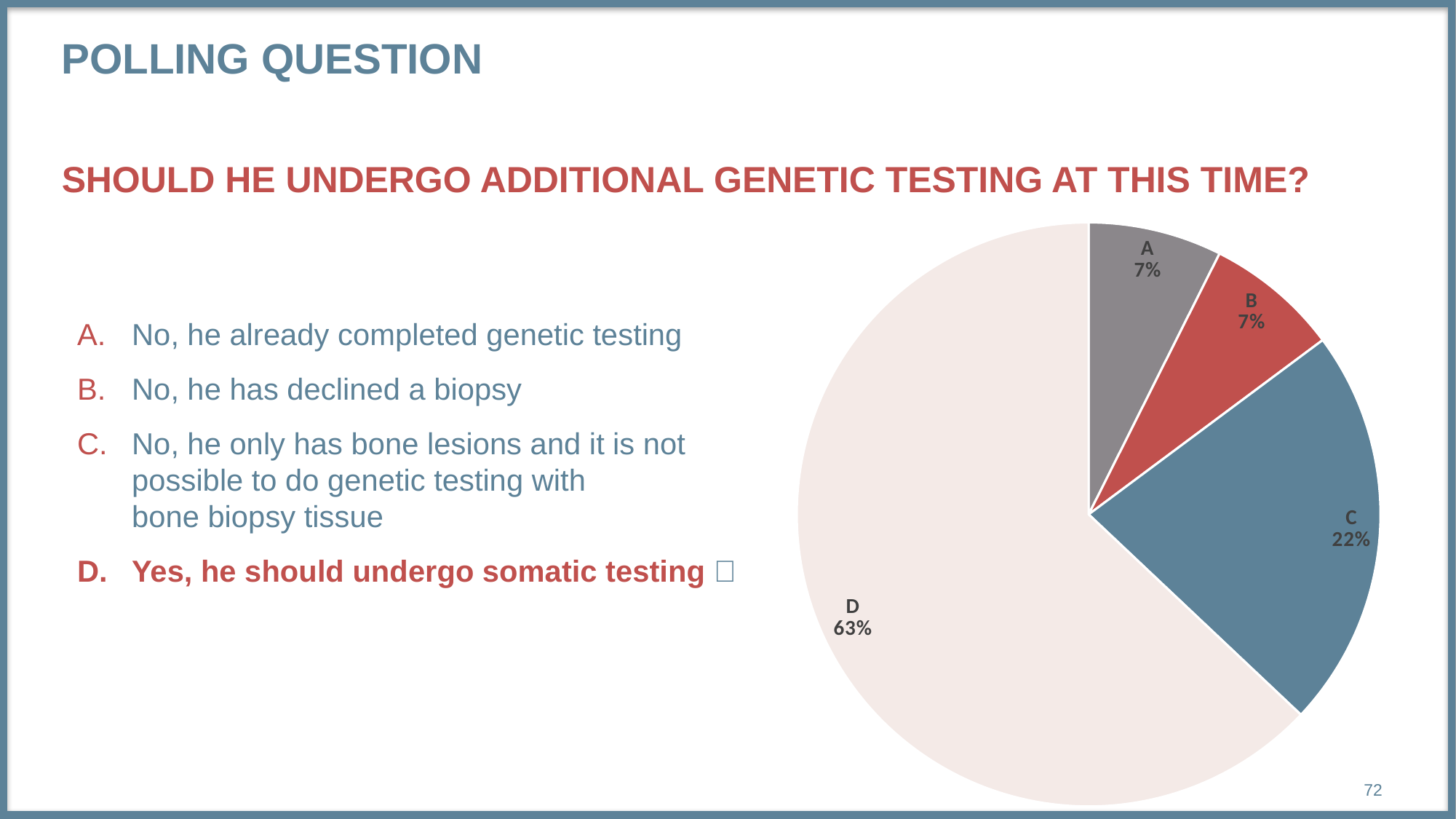
What colour is the slice for option C? Blue What percentage of responses does slice D represent? 63% What percentage of responses does slice C represent? 22% How many slices does the pie chart have? 4 Which is larger, the share for C or the share for B? C What is the combined share of slices A and B? 14% What percentage of responses does slice A represent? 7% What kind of chart is shown on the slide? Pie chart What is the difference in percentage points between slice D and slice C? 41 Which answer option received the largest share of responses? D What is the difference in percentage points between slice C and slice A? 15 What percentage of responses does slice B represent? 7%